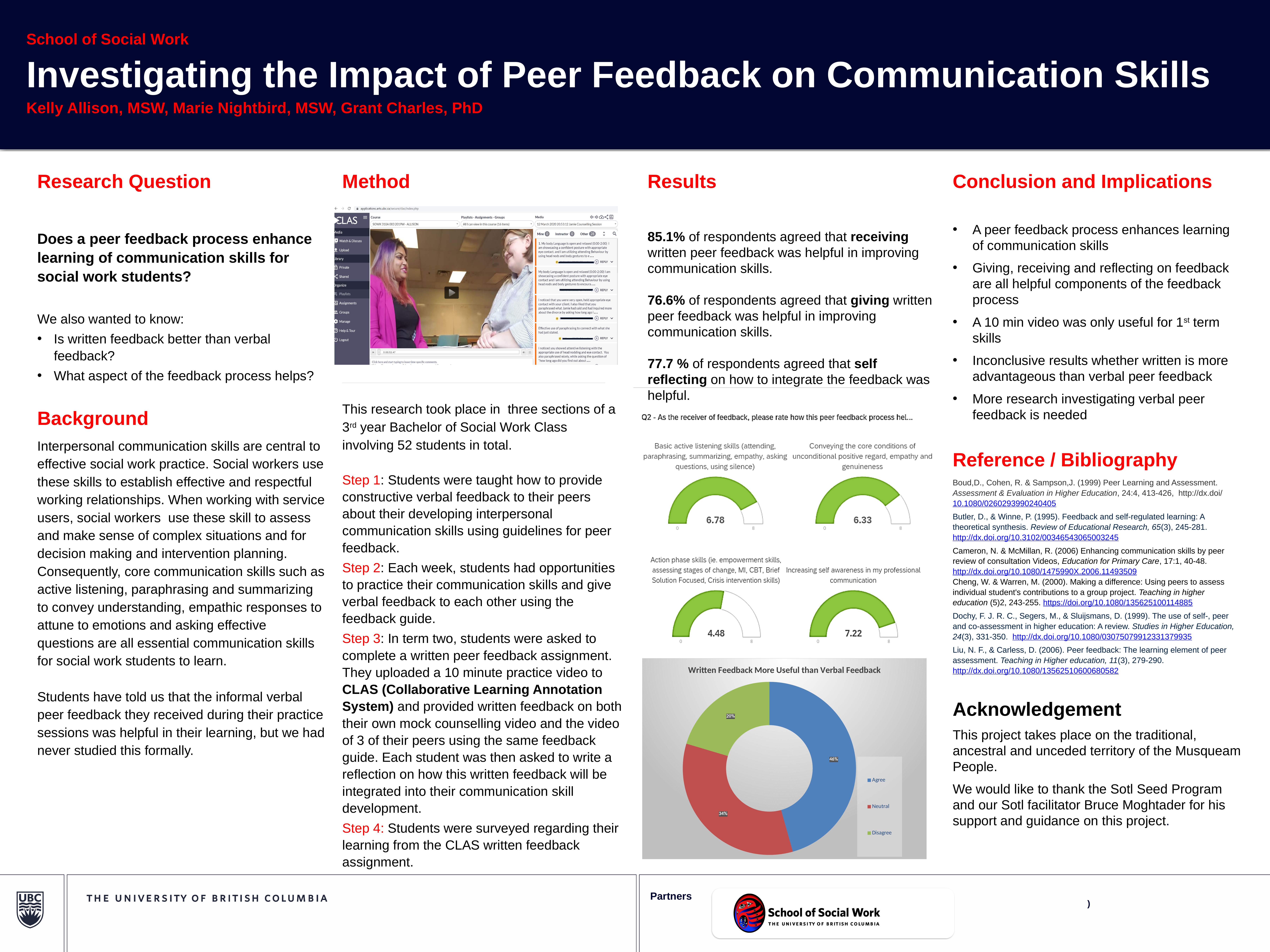
What kind of chart is the 'Written Feedback More Useful than Verbal Feedback' chart? Doughnut (pie) chart In the gauge charts under Q2, what is the value for 'Increasing self awareness in my professional communication'? 7.22 In the 'Written Feedback More Useful than Verbal Feedback' chart, what is the difference in percentage points between Agree and Neutral? 12 In the 'Written Feedback More Useful than Verbal Feedback' chart, which response category has the smallest share? Disagree In the 'Written Feedback More Useful than Verbal Feedback' chart, which response category has the largest share? Agree In the gauge charts under Q2, what is the value for 'Basic active listening skills'? 6.78 In the 'Written Feedback More Useful than Verbal Feedback' chart, what percentage of respondents chose Disagree? 20% In the 'Written Feedback More Useful than Verbal Feedback' chart, what percentage of respondents chose Agree? 46% In the 'Written Feedback More Useful than Verbal Feedback' chart, what percentage of respondents chose Neutral? 34% In the 'Written Feedback More Useful than Verbal Feedback' chart, how many categories does the legend list? 3 Among the four gauge charts under Q2, which item has the lowest value? Action phase skills In the gauge charts under Q2, what is the difference between the value for 'Increasing self awareness in my professional communication' and the value for 'Action phase skills'? 2.74